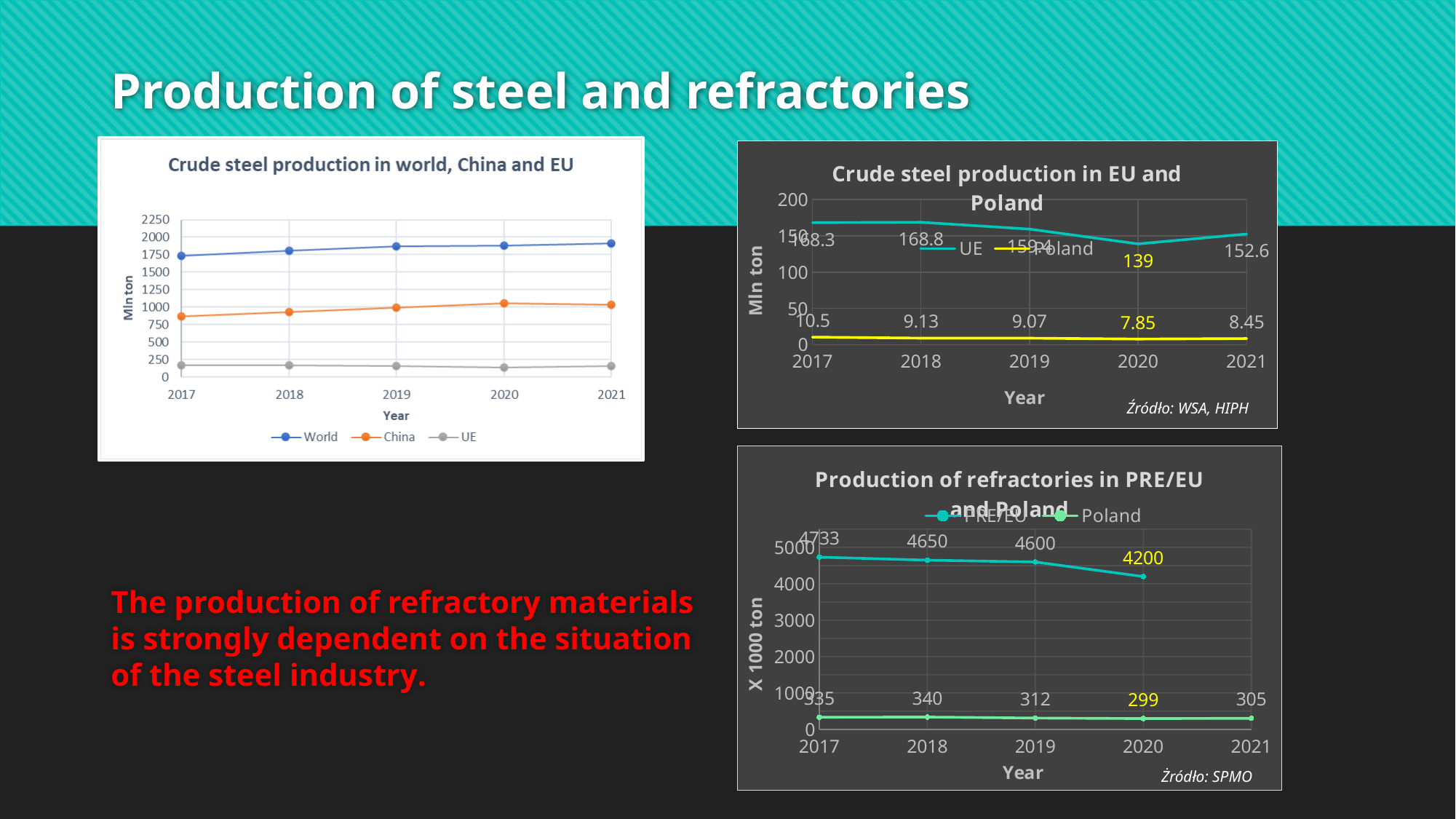
What kind of chart is 'Crude steel production in world, China and EU'? line chart In the chart 'Production of refractories in PRE/EU and Poland', what was the Poland value in 2021? 305 In the chart 'Crude steel production in EU and Poland', what is the difference between the UE values in 2018 and 2020? 29.8 In the chart 'Production of refractories in PRE/EU and Poland', is the Poland value for 2019 larger or smaller than the Poland value for 2020? larger In the chart 'Crude steel production in world, China and EU', how many series does the legend list? 3 In the chart 'Production of refractories in PRE/EU and Poland', what was the PRE/EU value in 2020? 4200 In the chart 'Crude steel production in world, China and EU', is the value for World in 2017 greater or less than 1500? greater In the chart 'Crude steel production in EU and Poland', which year had the lowest Poland value? 2020 In the chart 'Production of refractories in PRE/EU and Poland', which year had the highest Poland value? 2018 In the chart 'Crude steel production in EU and Poland', what was the Poland value in 2017? 10.5 In the chart 'Production of refractories in PRE/EU and Poland', what is the difference between the PRE/EU values in 2017 and 2020? 533 In the chart 'Crude steel production in EU and Poland', what was the UE value in 2020? 139